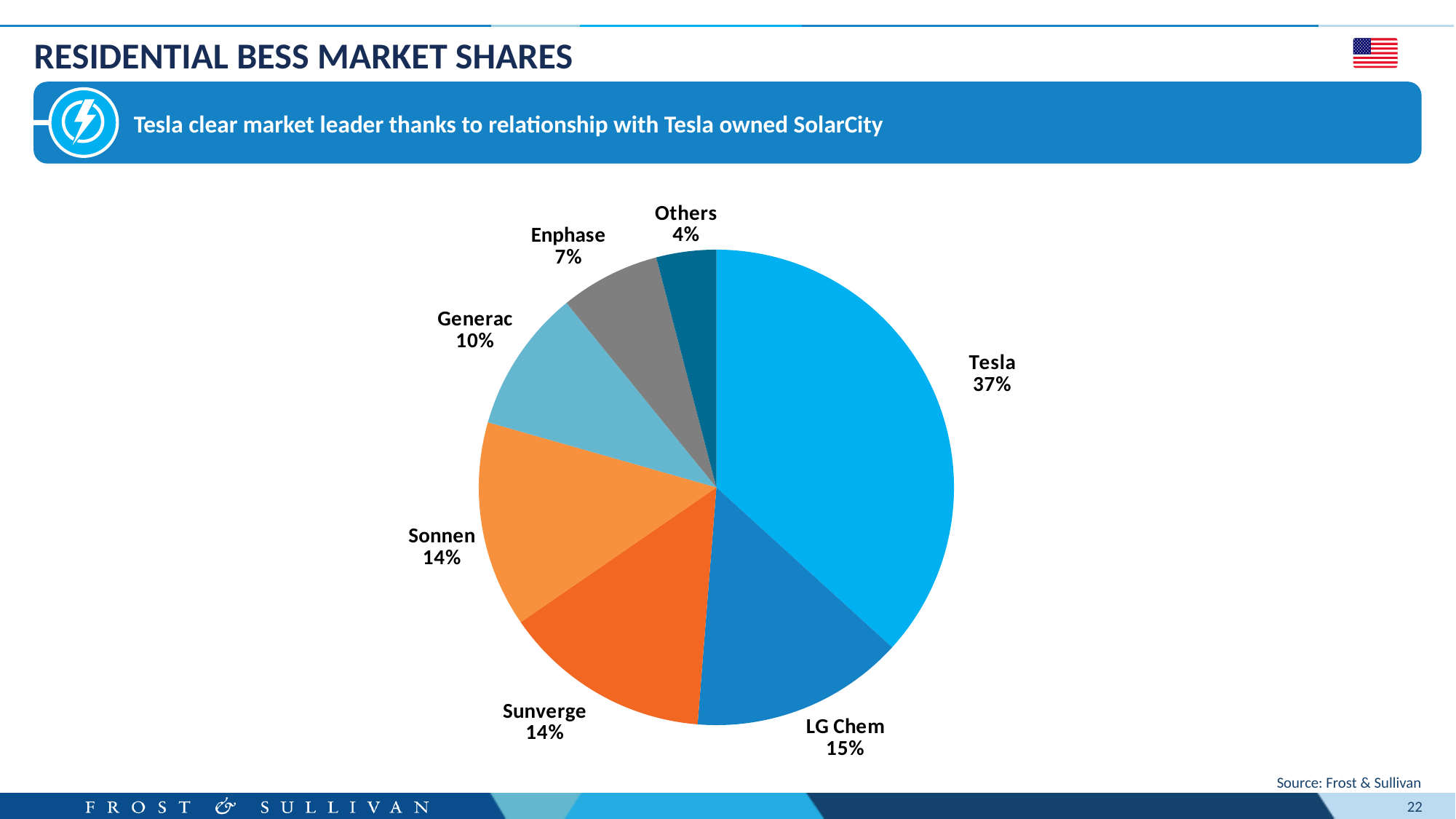
Which company has the largest market share? Tesla What kind of chart is shown on the slide? pie chart Which slice of the pie is the smallest? Others What is the combined share of Sonnen and Sunverge? 28% What is the title of the slide containing the chart? RESIDENTIAL BESS MARKET SHARES How many slices does the pie chart have? 7 What is Tesla's share of the residential BESS market? 37% What is the market share for Generac? 10% What is the market share for Enphase? 7% Which has a larger market share, Generac or Enphase? Generac What is the difference between Tesla's share and LG Chem's share? 22% What is LG Chem's market share? 15%